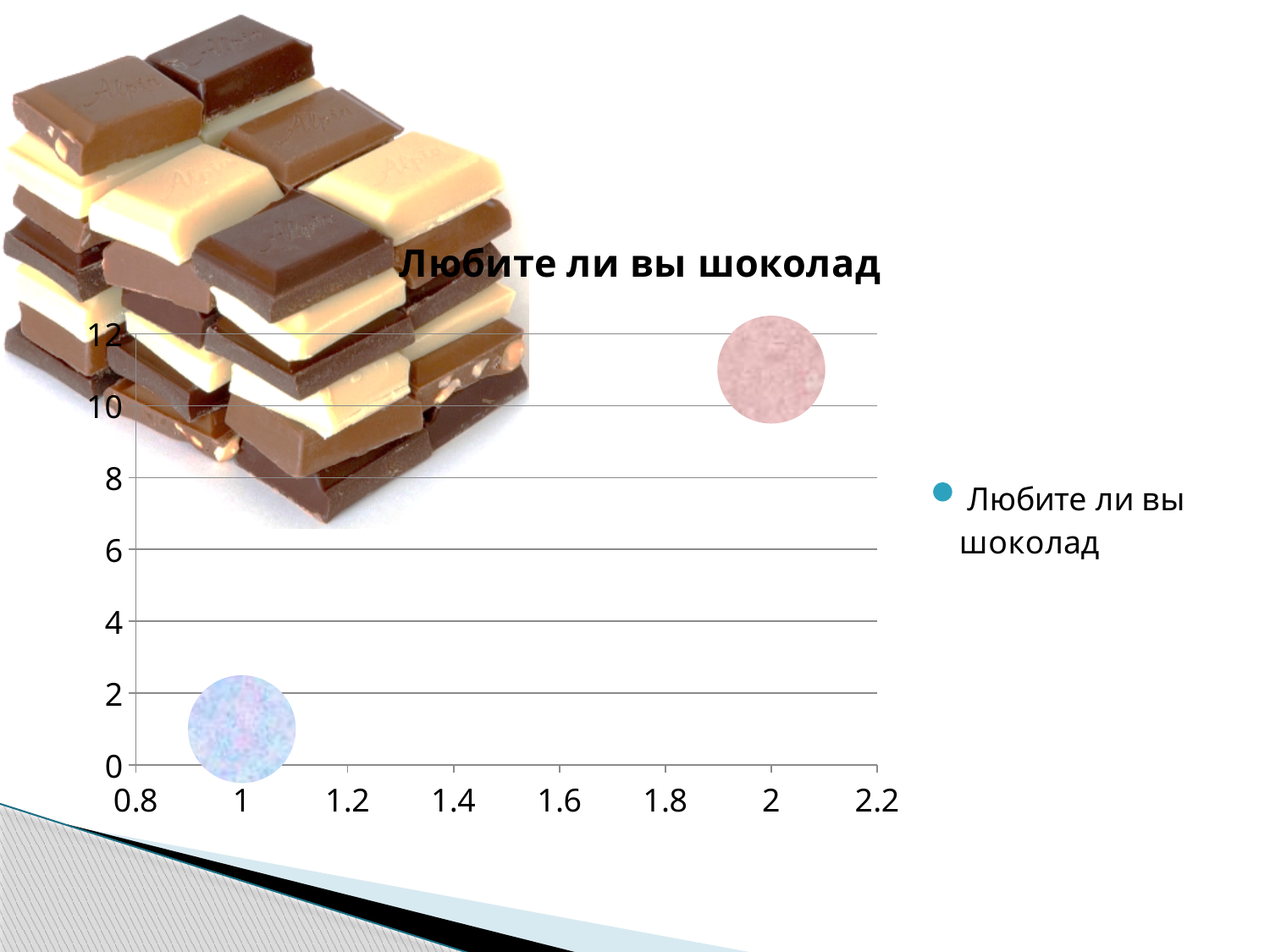
How many series does the legend list? 1 How many bubbles (data points) are plotted on the chart? 2 Is the y value of the bubble at x = 2 greater or less than 10? greater What kind of chart is shown on the slide? bubble chart Is the y value of the bubble at x = 2 greater or less than 12? less What is the title of the chart? Любите ли вы шоколад Is the y value of the bubble at x = 1 greater or less than 4? less Do the y values rise or fall as x increases from 1 to 2? rise Which bubble has the higher y value, the one at x = 1 or the one at x = 2? the one at x = 2 What is the legend entry of the chart? Любите ли вы шоколад What is the highest value shown on the y axis? 12